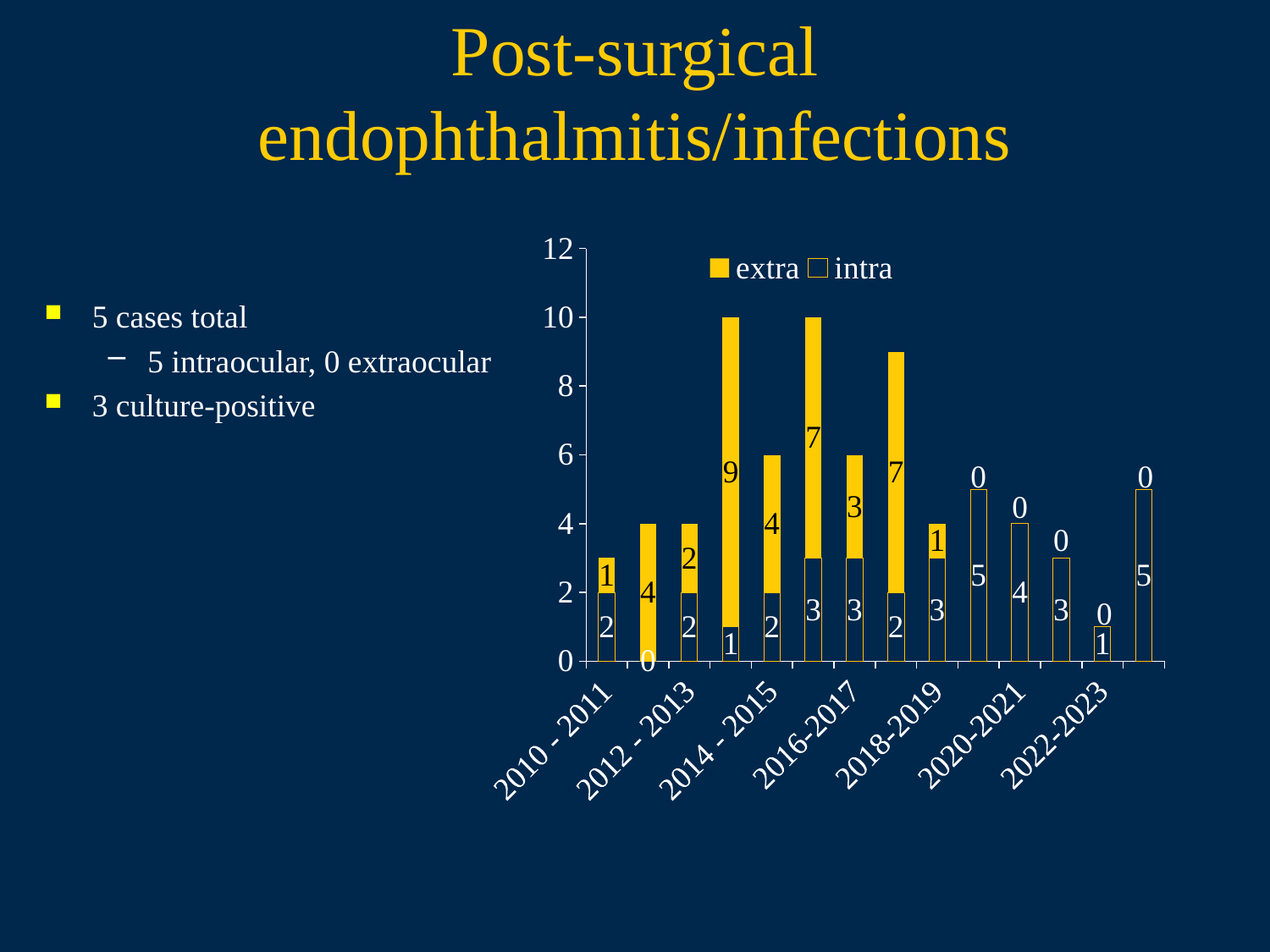
What is the extra value for 2014 - 2015? 4 What are the two series named in the chart legend? extra and intra Which has the larger intra value, 2020-2021 or 2022-2023? 2020-2021 What is the intra value for 2010 - 2011? 2 What is the intra value for 2016-2017? 3 What is the difference between the extra value for 2014 - 2015 and the extra value for 2018-2019? 3 What is the total of the stacked bar for 2018-2019? 4 What is the intra value for 2022-2023? 1 How many series does the chart legend list? 2 What is the extra value for 2020-2021? 0 What is the total of the stacked bar for 2010 - 2011? 3 What kind of chart is shown on the slide? bar chart